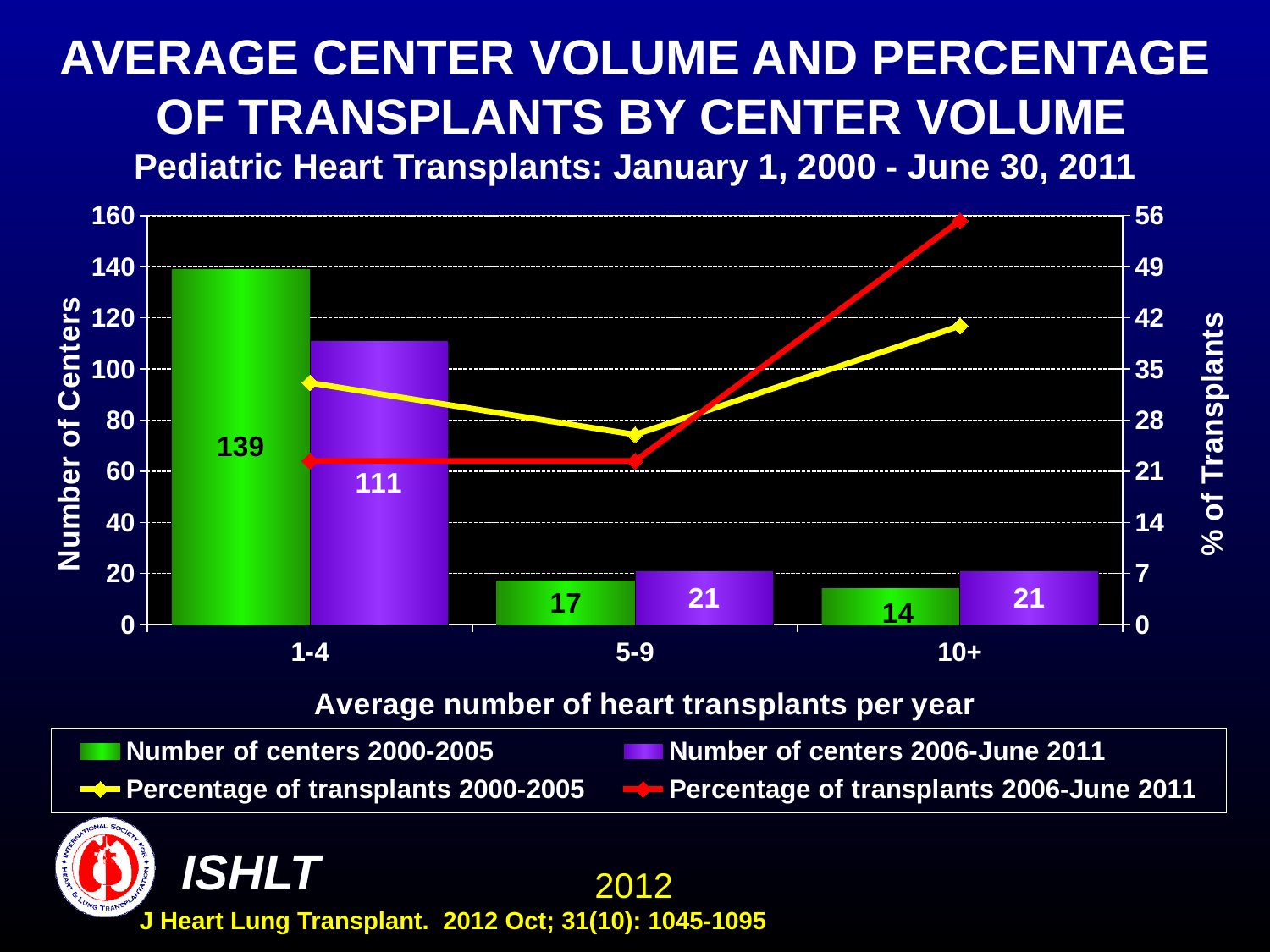
How many center volume categories are shown on the x axis? 3 What is the number of centers 2000-2005 for the 1-4 category? 139 What is the number of centers 2000-2005 for the 10+ category? 14 For the 5-9 category, which is larger: the number of centers 2000-2005 or 2006-June 2011? Number of centers 2006-June 2011 What is the difference between the number of centers 2000-2005 and 2006-June 2011 for the 1-4 category? 28 Which category has the lowest number of centers 2000-2005? 10+ Is the percentage of transplants 2006-June 2011 for the 10+ category greater or less than 49? greater Which category has the highest number of centers 2000-2005? 1-4 What kind of chart is shown on the slide? Combined bar and line chart What is the number of centers 2006-June 2011 for the 1-4 category? 111 How many series does the legend list? 4 Is the percentage of transplants 2006-June 2011 for the 1-4 category greater or less than 28? less